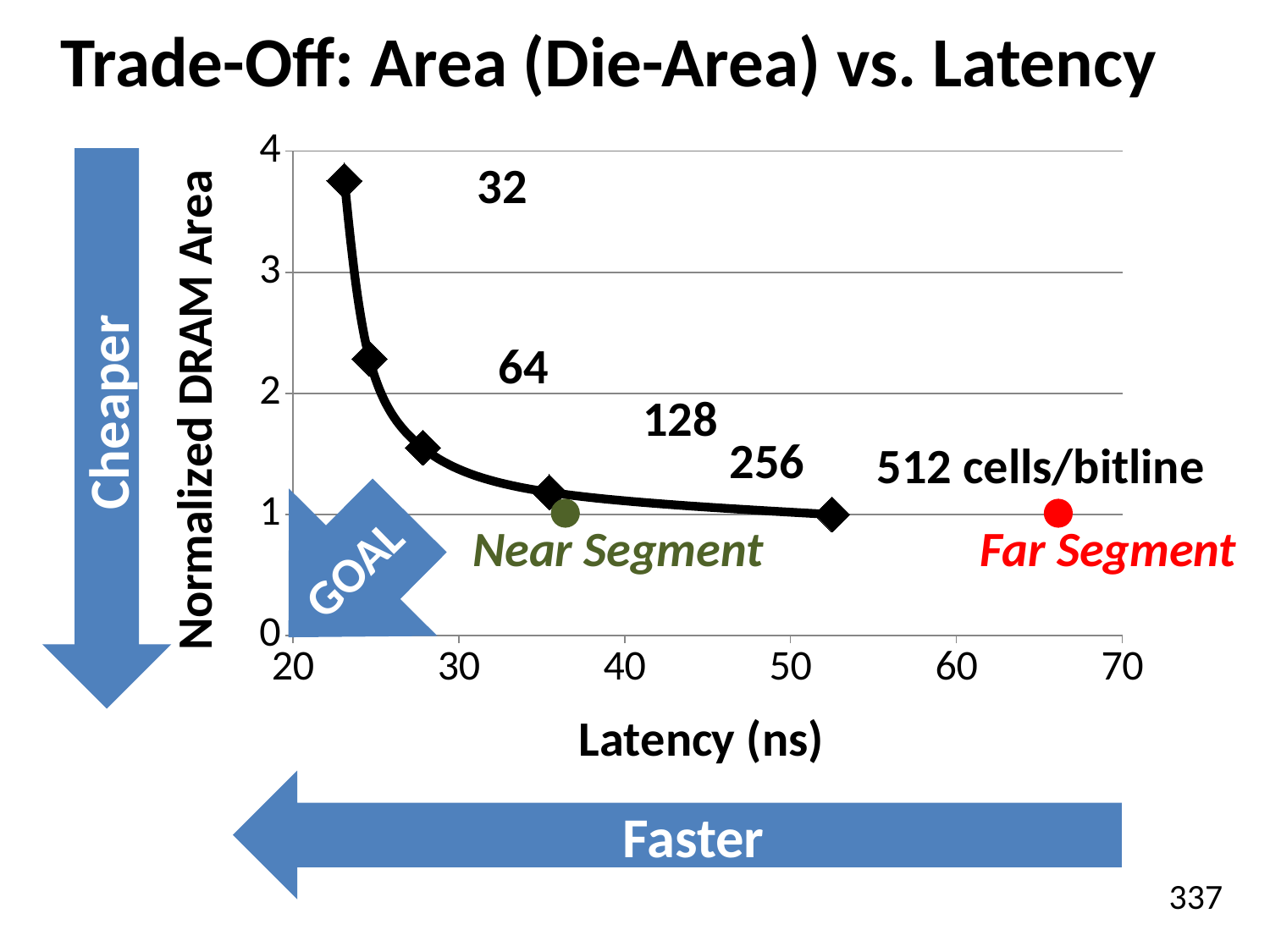
Is the normalized DRAM area for 32 cells/bitline greater or less than 3? greater Is the latency of the Far Segment point greater or less than 60 ns? greater What is the title of the x axis? Latency (ns) Which cells/bitline configuration on the black curve has the lowest normalized DRAM area? 512 Which cells/bitline configuration has the highest normalized DRAM area? 32 What kind of chart is shown on the slide? line chart How many data points are plotted on the black curve? 5 What colour is the Far Segment point? red Is the normalized DRAM area for 64 cells/bitline greater or less than 2? greater Which has a larger normalized DRAM area, 64 cells/bitline or 128 cells/bitline? 64 As latency increases along the x axis, does the normalized DRAM area rise or fall? fall